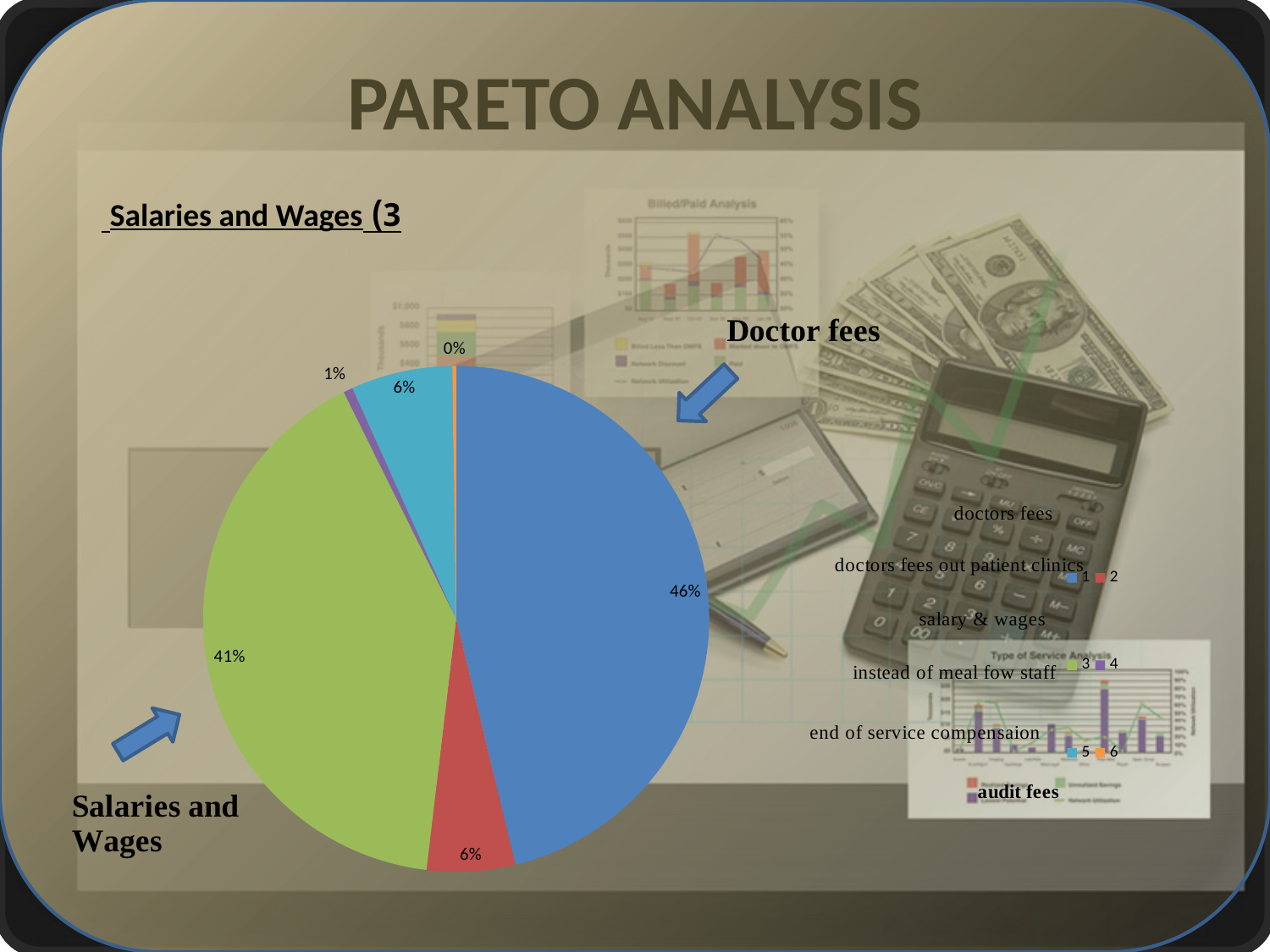
What percentage is shown on the orange slice of the pie chart? 0% How many slices does the pie chart have? 6 Which is larger in the pie chart: the blue slice or the green slice? the blue slice What percentage is shown on the purple slice of the pie chart? 1% What is the difference in percentage points between the blue slice (46%) and the green slice (41%)? 5 What percentage is shown on the blue slice of the pie chart (the one the 'Doctor fees' arrow points to)? 46% What percentage is shown on the red slice of the pie chart? 6% How many entries does the pie chart's legend list? 6 What kind of chart is shown on the slide? pie chart Which slice of the pie chart is the smallest? the orange slice, 0% Which slice of the pie chart is the largest? the blue slice (Doctor fees), 46% What percentage is shown on the green slice of the pie chart (the one the 'Salaries and Wages' arrow points to)? 41%